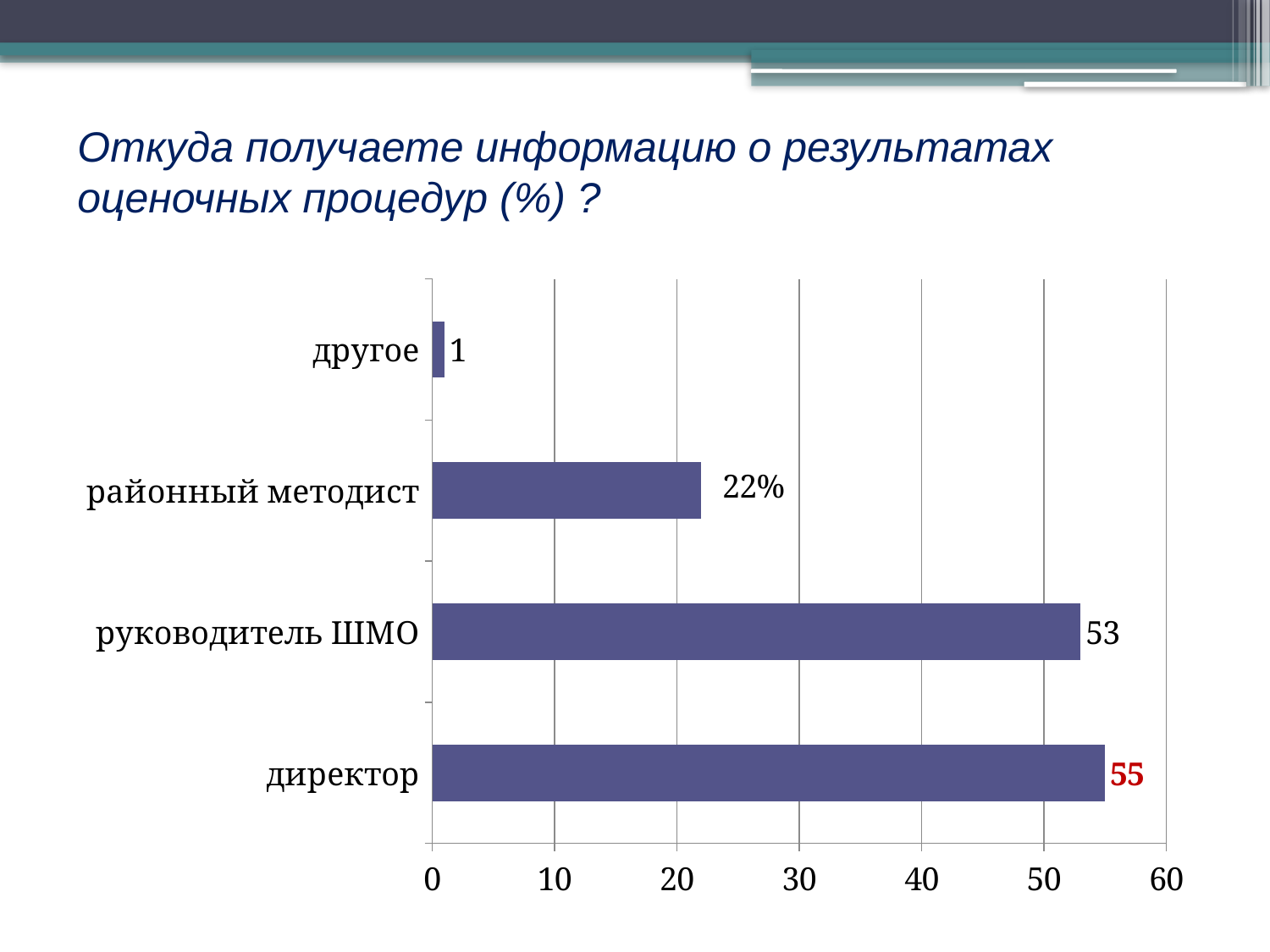
How many categories are shown in the chart? 4 What is the difference between the values for руководитель ШМО and районный методист? 31 What is the difference between the values for директор and руководитель ШМО? 2 Which is larger, the value for районный методист or the value for руководитель ШМО? руководитель ШМО What kind of chart is shown on the slide? bar chart What is the value for районный методист? 22% What is the value for руководитель ШМО? 53 Is the value for районный методист greater or less than 30? less Which category has the highest value? директор Which category has the lowest value? другое What is the value for другое? 1 What is the value for директор? 55